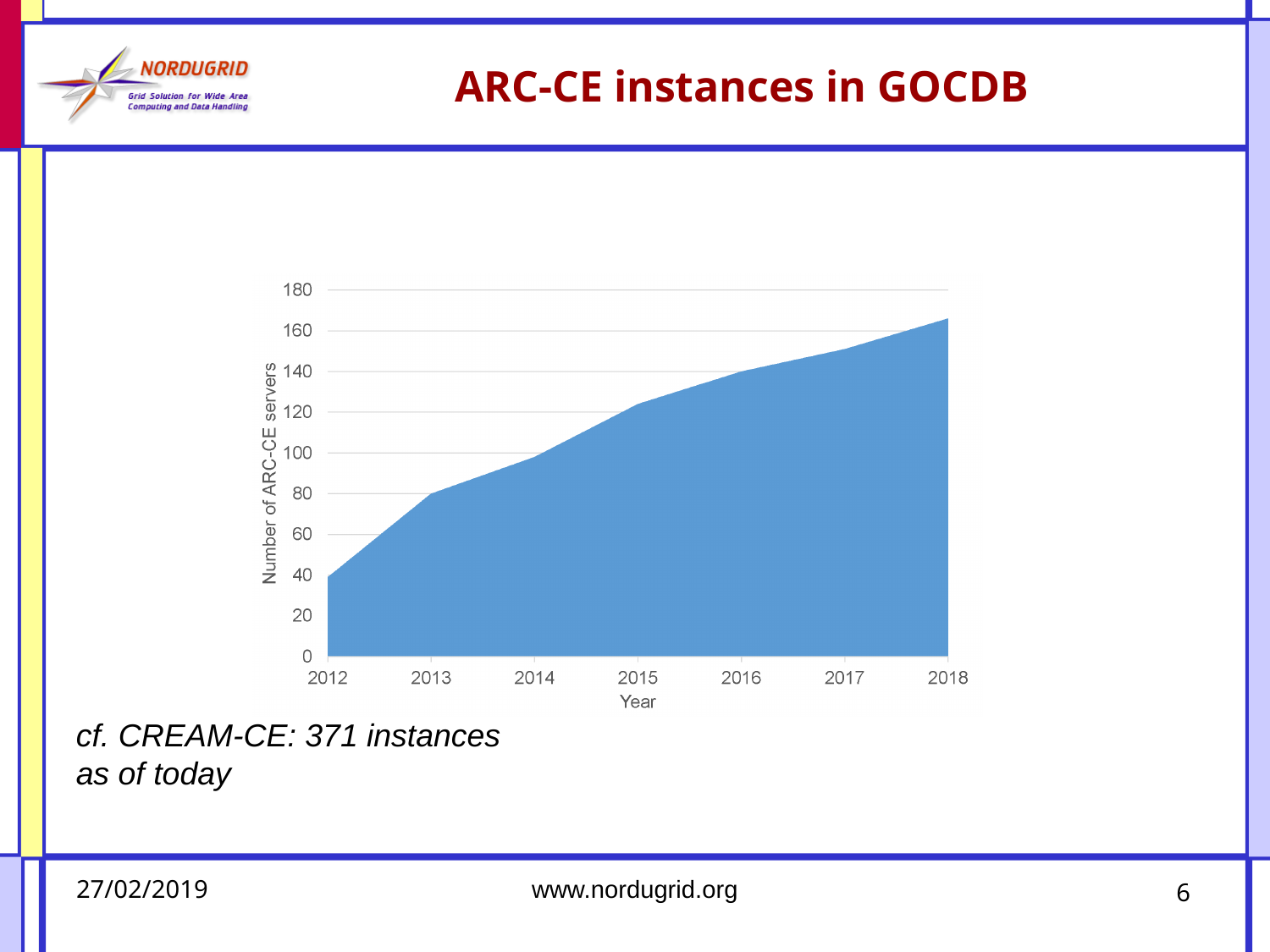
Is the number of ARC-CE servers in 2014 greater or less than 80? greater Which year has the lowest number of ARC-CE servers? 2012 Which year has more ARC-CE servers, 2013 or 2017? 2017 Is the number of ARC-CE servers in 2018 greater or less than 160? greater Does the number of ARC-CE servers rise or fall from 2012 to 2018? rise Is the number of ARC-CE servers in 2016 greater or less than 160? less How many years are labelled on the x axis of the chart? 7 What kind of chart is shown on the slide? area chart What is the label of the y axis of the chart? Number of ARC-CE servers Which year has the highest number of ARC-CE servers? 2018